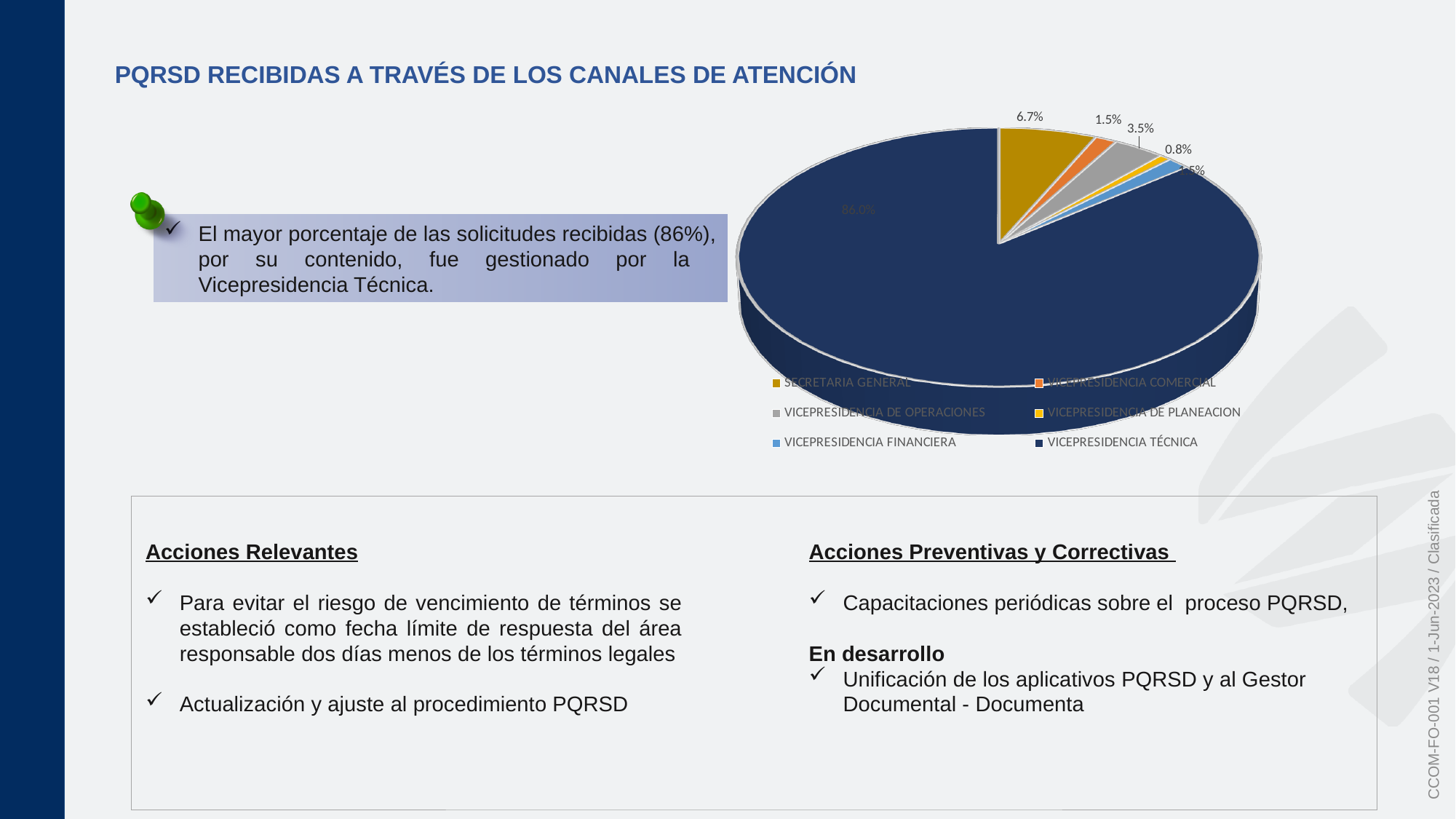
How many entries does the legend of the pie chart list? 6 Which category has the smallest slice in the pie chart? VICEPRESIDENCIA DE PLANEACION What percentage does the pie chart show for VICEPRESIDENCIA COMERCIAL? 1.5% What percentage does the pie chart show for VICEPRESIDENCIA DE PLANEACION? 0.8% What kind of chart is shown on the slide? Pie chart Which category has the largest slice in the pie chart? VICEPRESIDENCIA TÉCNICA What is the difference in percentage points between SECRETARIA GENERAL and VICEPRESIDENCIA DE OPERACIONES in the pie chart? 3.2% What percentage does the pie chart show for SECRETARIA GENERAL? 6.7% Which slice is larger in the pie chart, VICEPRESIDENCIA DE OPERACIONES or VICEPRESIDENCIA COMERCIAL? VICEPRESIDENCIA DE OPERACIONES How many slices does the pie chart have? 6 What percentage does the pie chart show for VICEPRESIDENCIA TÉCNICA? 86.0% What percentage does the pie chart show for VICEPRESIDENCIA DE OPERACIONES? 3.5%